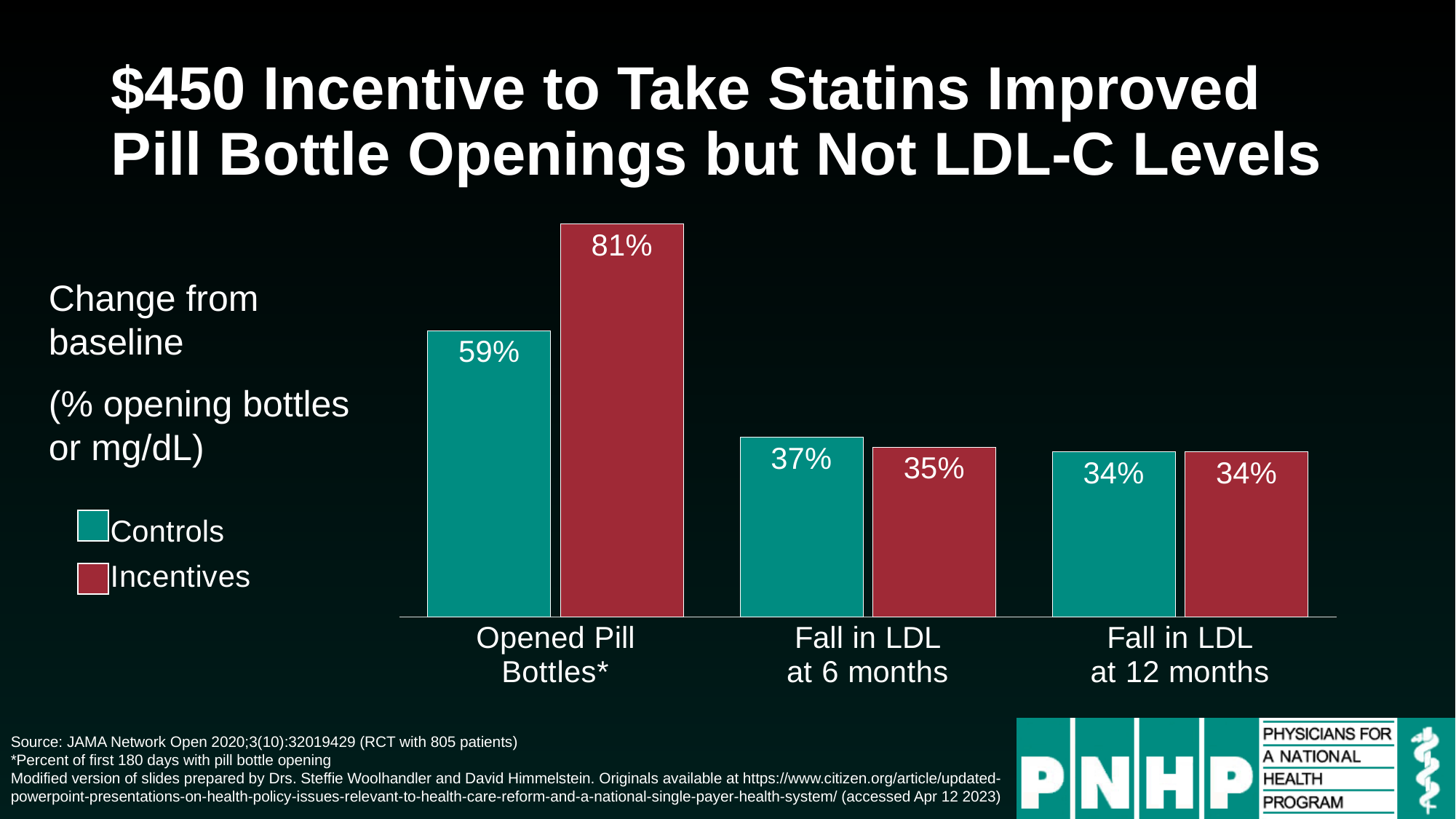
How many series does the legend list? 2 Which category has the lowest value for the Controls series? Fall in LDL at 12 months For Opened Pill Bottles*, which series has the larger value, Controls or Incentives? Incentives What is the value for Incentives in the Opened Pill Bottles* category? 81% What is the value for Incentives for Fall in LDL at 12 months? 34% What is the difference between the Incentives and Controls values for Opened Pill Bottles*? 22% What is the value for Controls in the Opened Pill Bottles* category? 59% What is the value for Incentives for Fall in LDL at 6 months? 35% What is the value for Controls for Fall in LDL at 6 months? 37% Which category has the highest value for the Incentives series? Opened Pill Bottles* What kind of chart is shown on the slide? Bar chart How many categories are shown on the x axis? 3